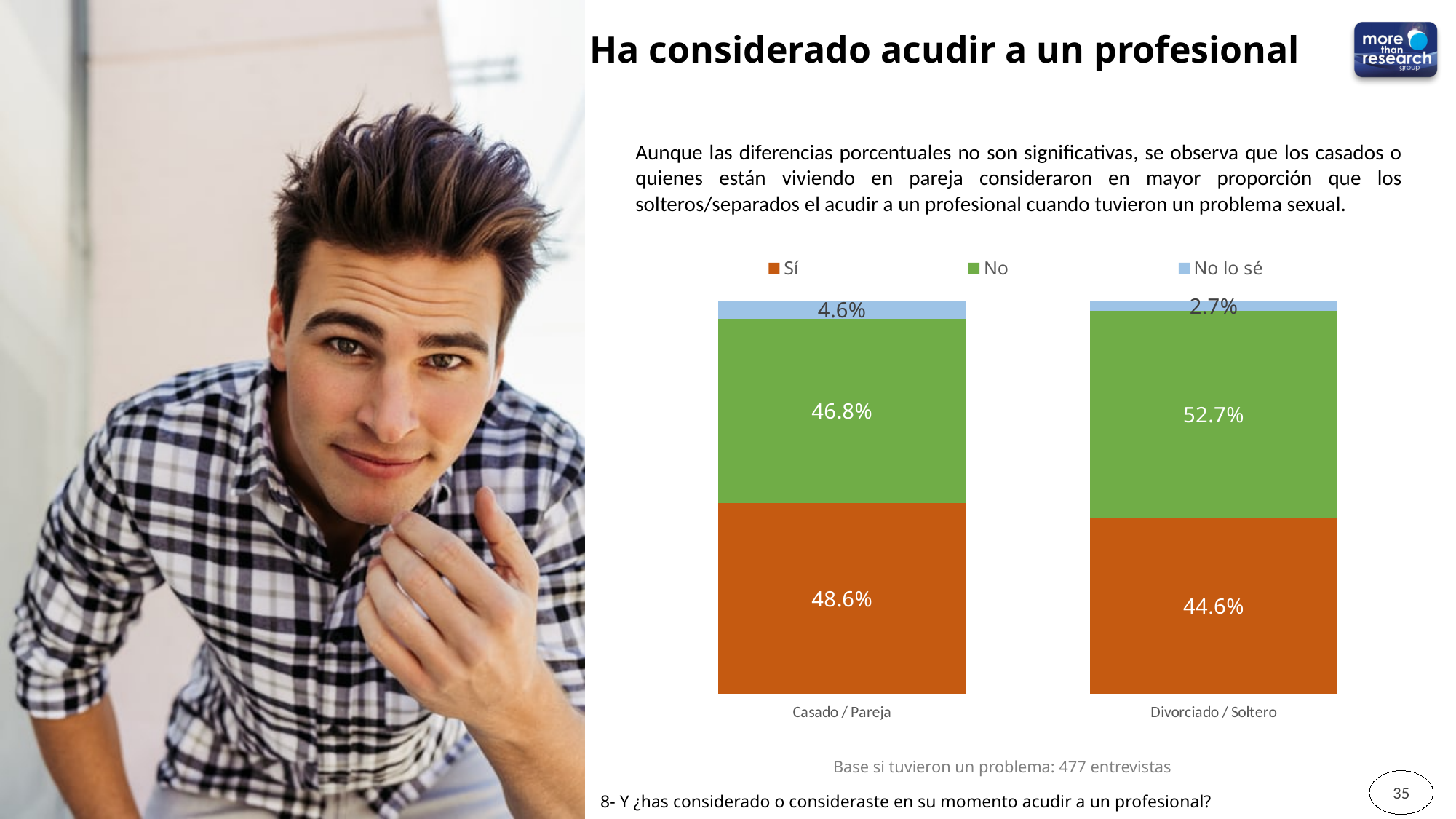
Which category has the higher "No" value? Divorciado / Soltero What is the value for "No" in the Divorciado / Soltero bar? 52.7% What is the value for "Sí" in the Casado / Pareja bar? 48.6% How many series does the legend list? 3 What kind of chart is shown on the slide? Stacked bar chart What is the value for "Sí" in the Divorciado / Soltero bar? 44.6% How many categories are shown on the x axis of the chart? 2 What is the value for "No lo sé" in the Divorciado / Soltero bar? 2.7% Which category has the higher "Sí" value, Casado / Pareja or Divorciado / Soltero? Casado / Pareja What is the difference between the "No" values for Divorciado / Soltero and Casado / Pareja? 5.9% What is the difference between the "Sí" values for Casado / Pareja and Divorciado / Soltero? 4.0% What is the value for "No lo sé" in the Casado / Pareja bar? 4.6%